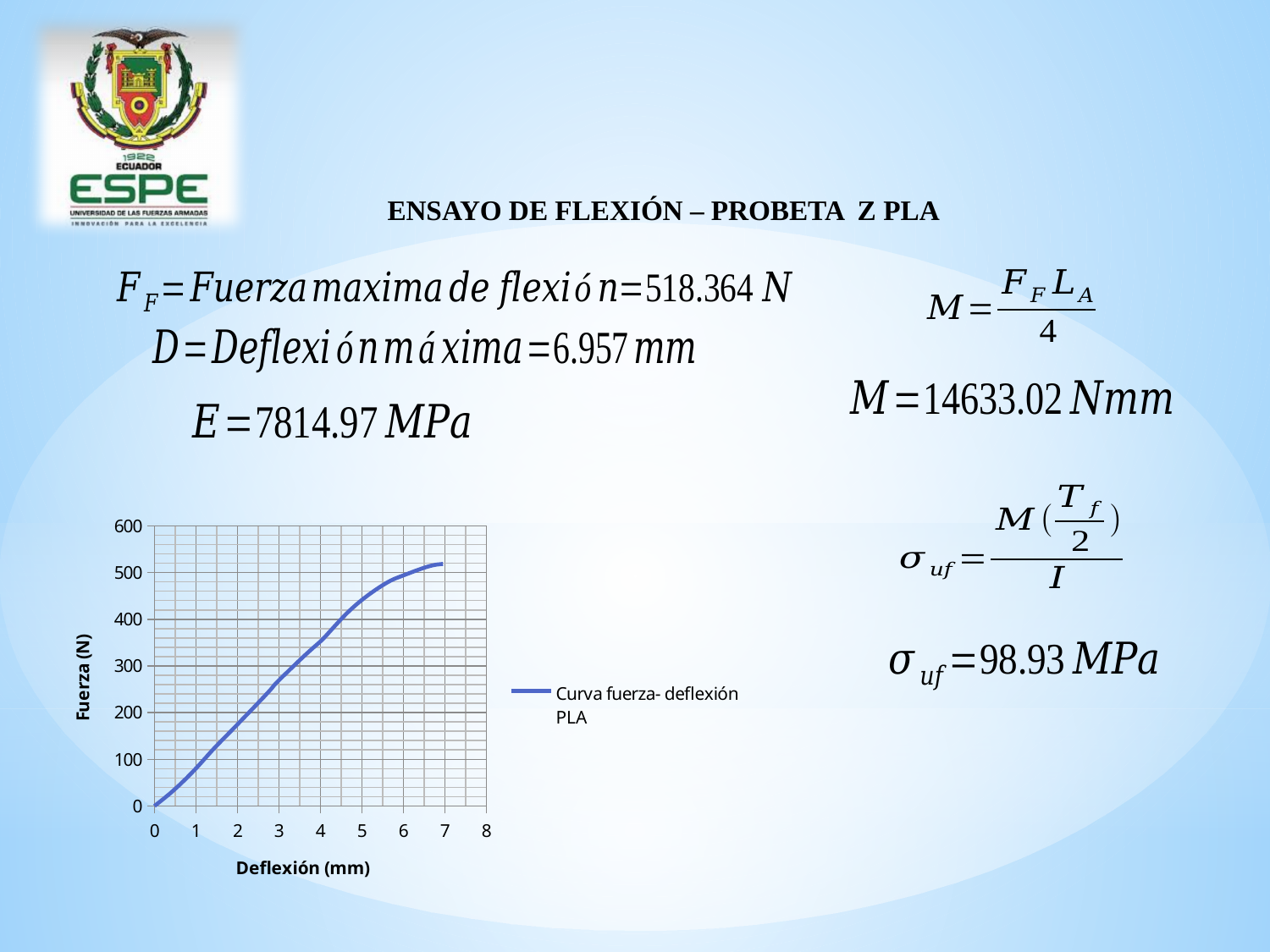
Is the highest force reached by the curve greater or less than 500? greater What kind of chart is shown on the slide? line chart Is the force at a deflection of 4 mm greater or less than 300? greater Does the force rise or fall as deflection increases along the x axis? rise How many series does the chart legend list? 1 Is the force at a deflection of 6 mm greater or less than 400? greater What is the label of the vertical axis of the chart? Fuerza (N) What is the legend entry for the plotted series? Curva fuerza- deflexión PLA